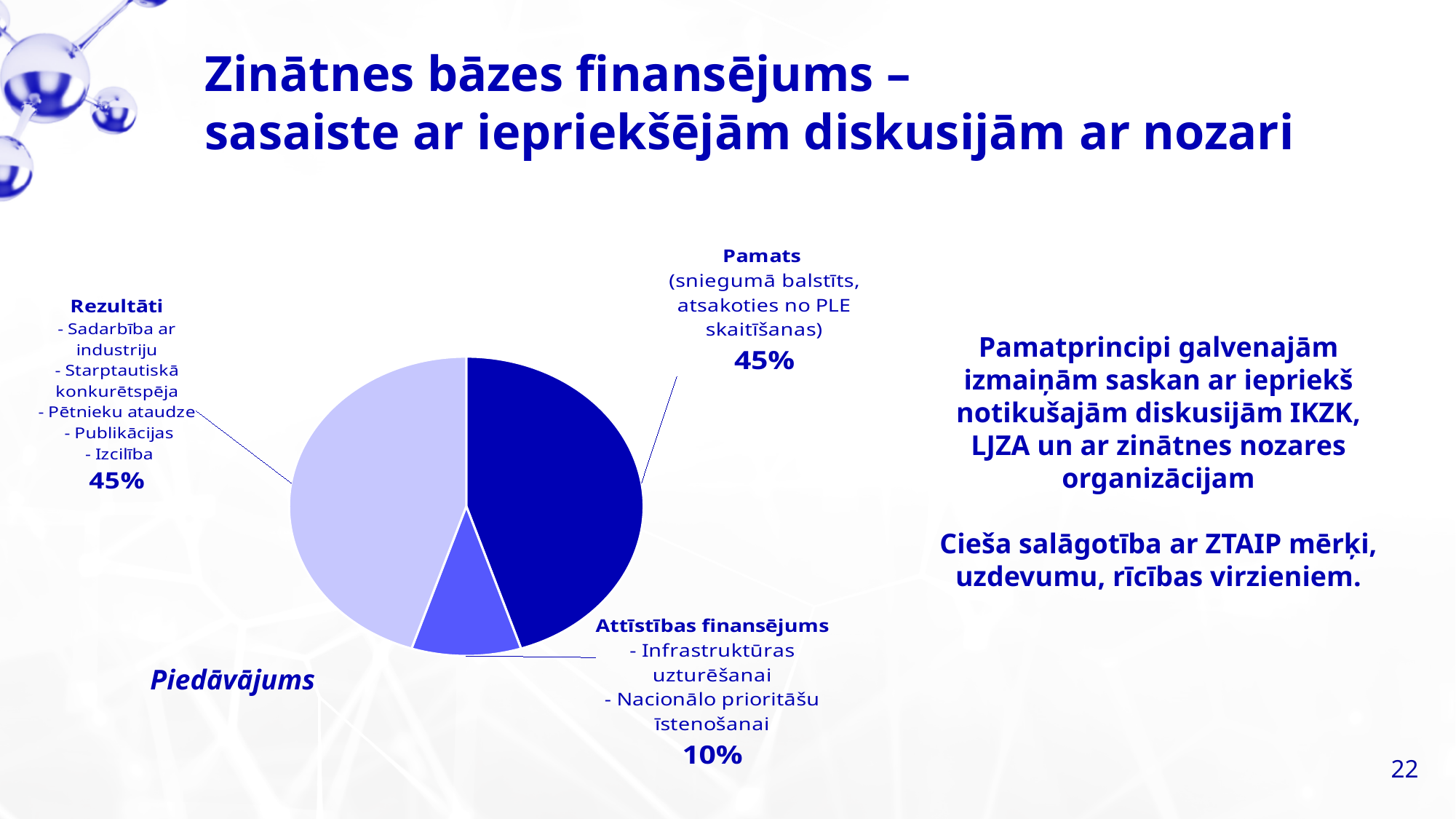
Which slice of the pie chart is the smallest? Attīstības finansējums What label appears in italics below the pie chart? Piedāvājums Which slice of the pie chart is coloured the darkest blue? Pamats What is the combined share of the Pamats and Rezultāti slices? 90% Which is larger in the pie chart: the Pamats slice or the Attīstības finansējums slice? Pamats What share of the pie chart does the Attīstības finansējums slice represent? 10% What is the difference in percentage points between the Rezultāti slice and the Attīstības finansējums slice? 35% What share of the pie chart does the Rezultāti slice represent? 45% What kind of chart is shown on the slide? Pie chart What share of the pie chart does the Pamats slice represent? 45% Do the Pamats and Rezultāti slices have the same share of the pie chart? Yes, both 45% How many slices does the pie chart have? 3